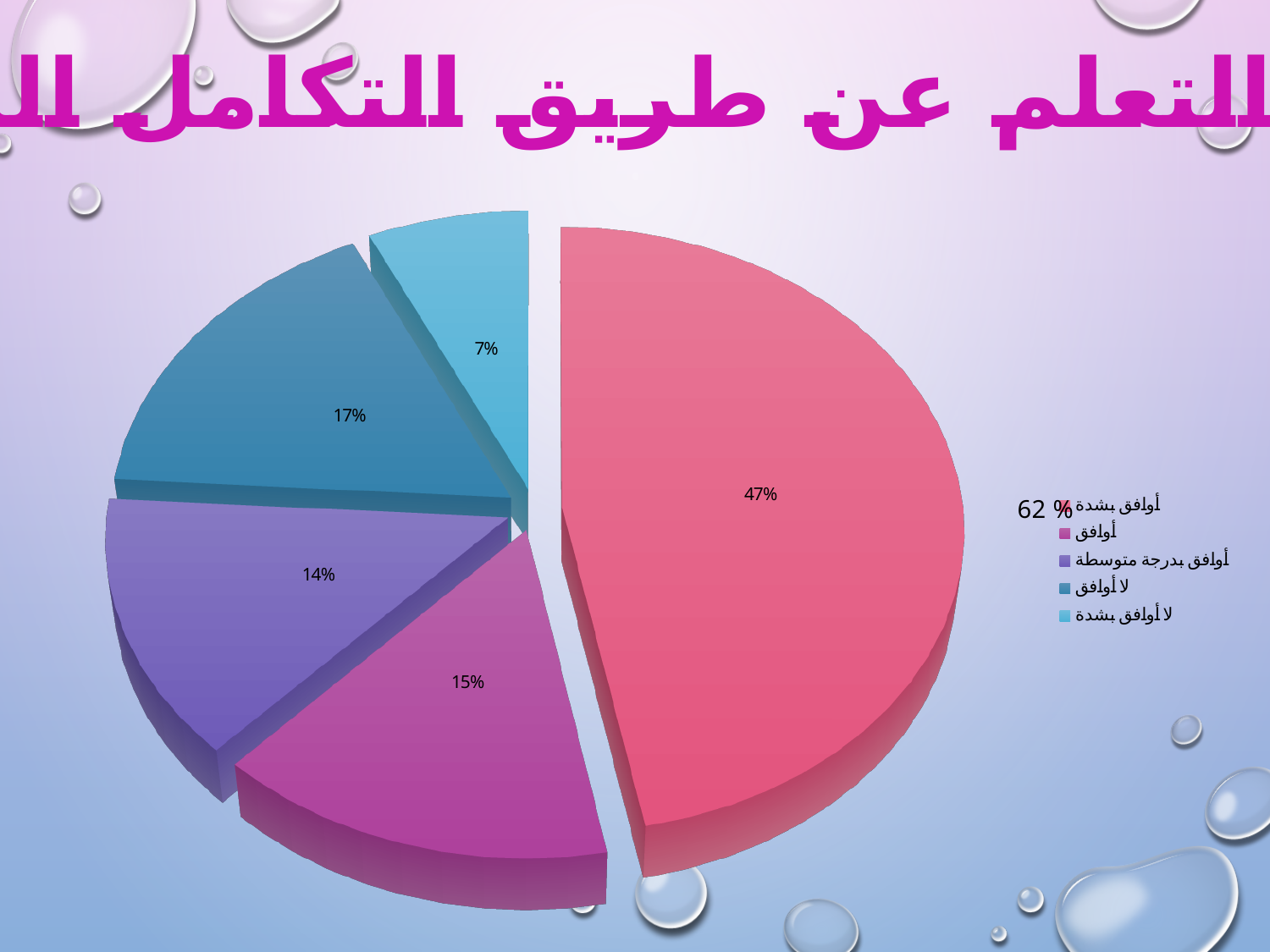
What percentage is shown for the slice labelled أوافق بدرجة متوسطة? 14% What colour is the slice for لا أوافق بشدة? light blue What percentage is shown for the slice labelled لا أوافق بشدة? 7% What is the difference in percentage points between the أوافق بشدة slice and the لا أوافق slice? 30 Which category has the smallest slice of the pie? لا أوافق بشدة What percentage is shown for the slice labelled أوافق بشدة? 47% What percentage is shown for the slice labelled لا أوافق? 17% How many slices does the pie chart have? 5 Which category has the largest slice of the pie? أوافق بشدة What kind of chart is shown on the slide? pie chart How many entries does the legend list? 5 Which slice is larger, أوافق or أوافق بدرجة متوسطة? أوافق